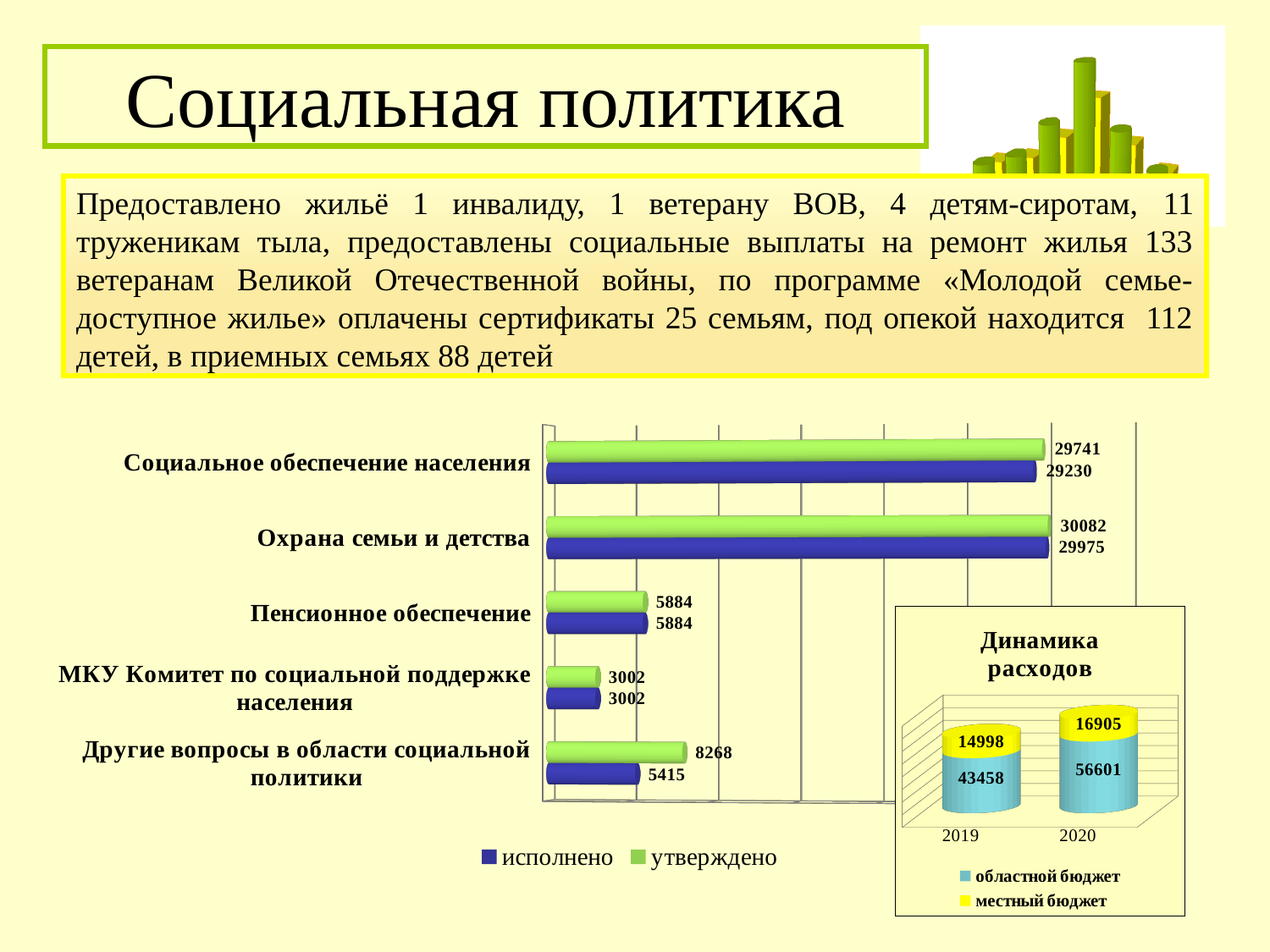
In the horizontal bar chart on the left, how many series does the legend list? 2 In the horizontal bar chart on the left, how many categories are shown? 5 In the horizontal bar chart on the left, what is the 'утверждено' value for 'Охрана семьи и детства'? 30082 In the 'Динамика расходов' chart, what is the 'местный бюджет' value for 2019? 14998 In the horizontal bar chart on the left, what is the 'исполнено' value for 'Другие вопросы в области социальной политики'? 5415 In the 'Динамика расходов' chart, what is the total of the stacked bar for 2020? 73506 In the 'Динамика расходов' chart, do the 'областной бюджет' values rise or fall from 2019 to 2020? rise In the horizontal bar chart on the left, which category has the lowest 'исполнено' value? МКУ Комитет по социальной поддержке населения In the horizontal bar chart on the left, which is larger: the 'исполнено' value for 'Социальное обеспечение населения' or for 'Пенсионное обеспечение'? Социальное обеспечение населения In the 'Динамика расходов' chart, what is the difference between the 'областной бюджет' values for 2020 and 2019? 13143 In the horizontal bar chart on the left, what is the difference between the 'утверждено' and 'исполнено' values for 'Другие вопросы в области социальной политики'? 2853 In the 'Динамика расходов' chart, what is the 'областной бюджет' value for 2020? 56601